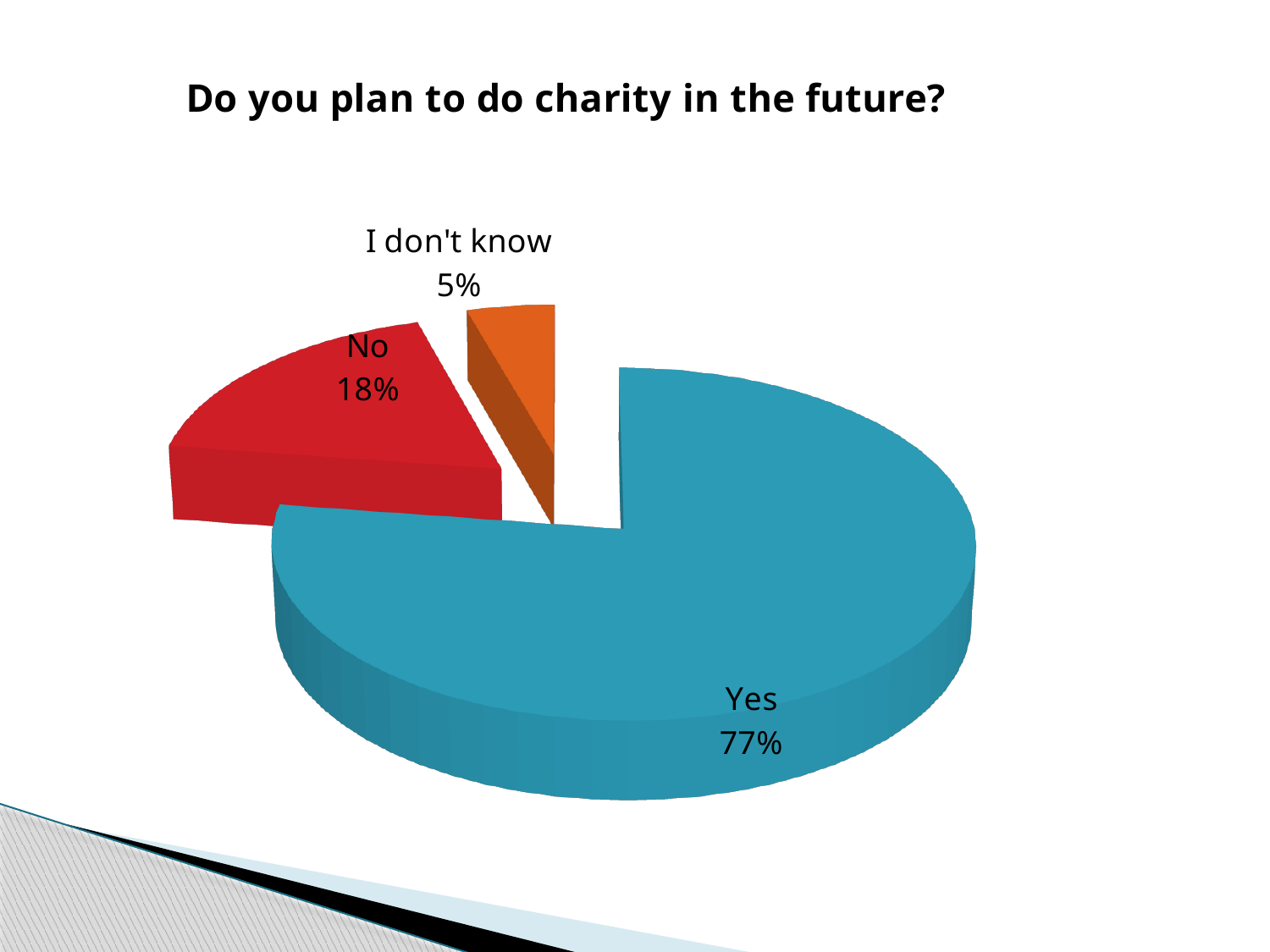
What is the difference in percentage points between "Yes" and "No"? 59 What percentage of respondents answered "No"? 18% Which answer has the largest share of the pie? Yes What is the title of the chart? Do you plan to do charity in the future? What percentage of respondents answered "I don't know"? 5% Which answer has the smallest share of the pie? I don't know How many slices does the pie chart have? 3 What colour is the "Yes" slice? blue What percentage of respondents answered "Yes"? 77% What is the difference in percentage points between "No" and "I don't know"? 13 Which is larger, the share for "No" or the share for "I don't know"? No What kind of chart is shown on the slide? pie chart